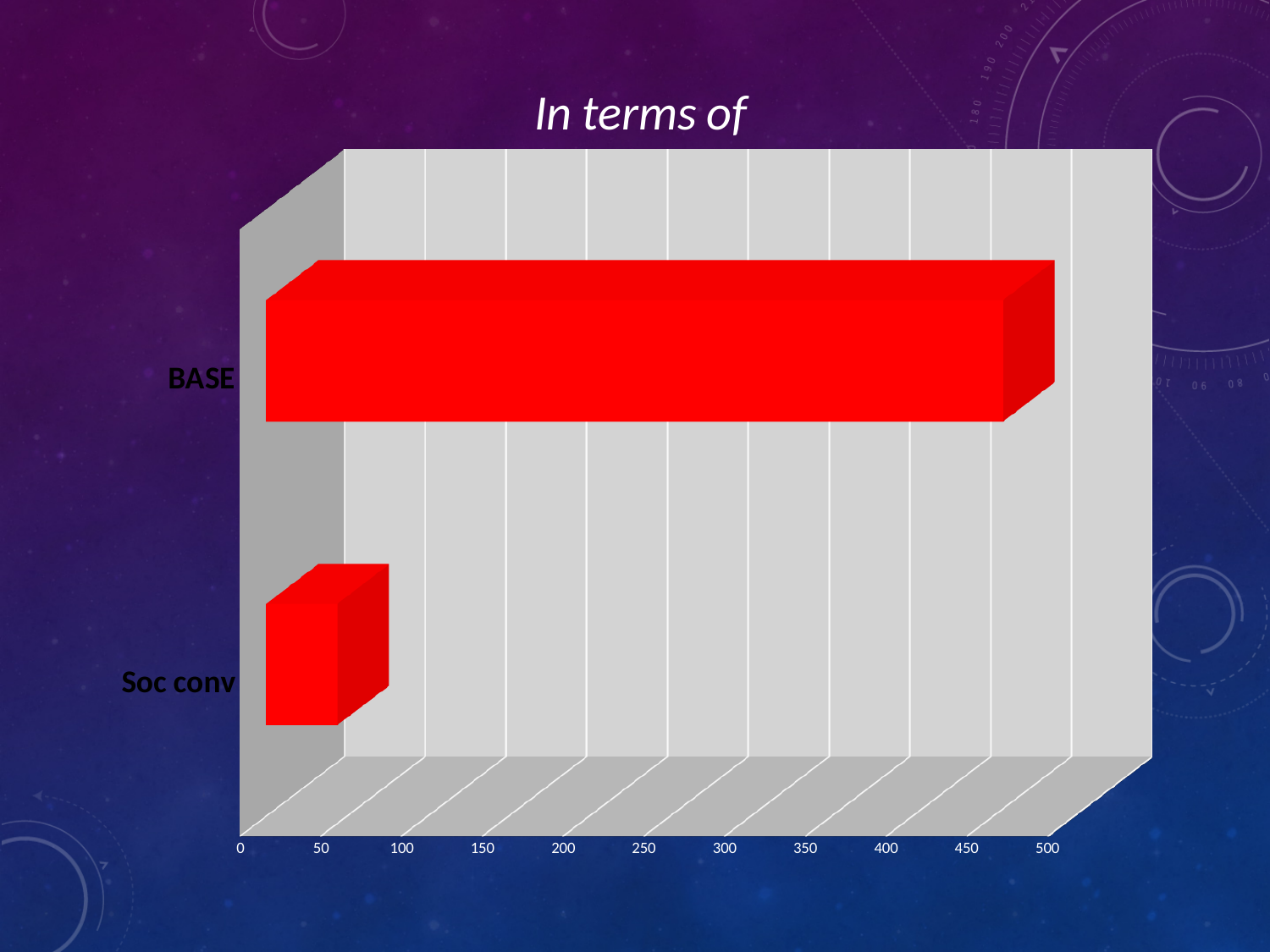
Which is larger, the value for BASE or the value for Soc conv? BASE Is the value for BASE greater or less than 400? greater How many categories are plotted in the chart? 2 Is the value for BASE greater or less than 300? greater What colour are the bars in the chart? red What kind of chart is shown on the slide? bar chart Which category has the highest value? BASE Which category has the lowest value? Soc conv Is the value for Soc conv greater or less than 200? less What is the title of the chart? In terms of What is the highest value shown on the horizontal axis? 500